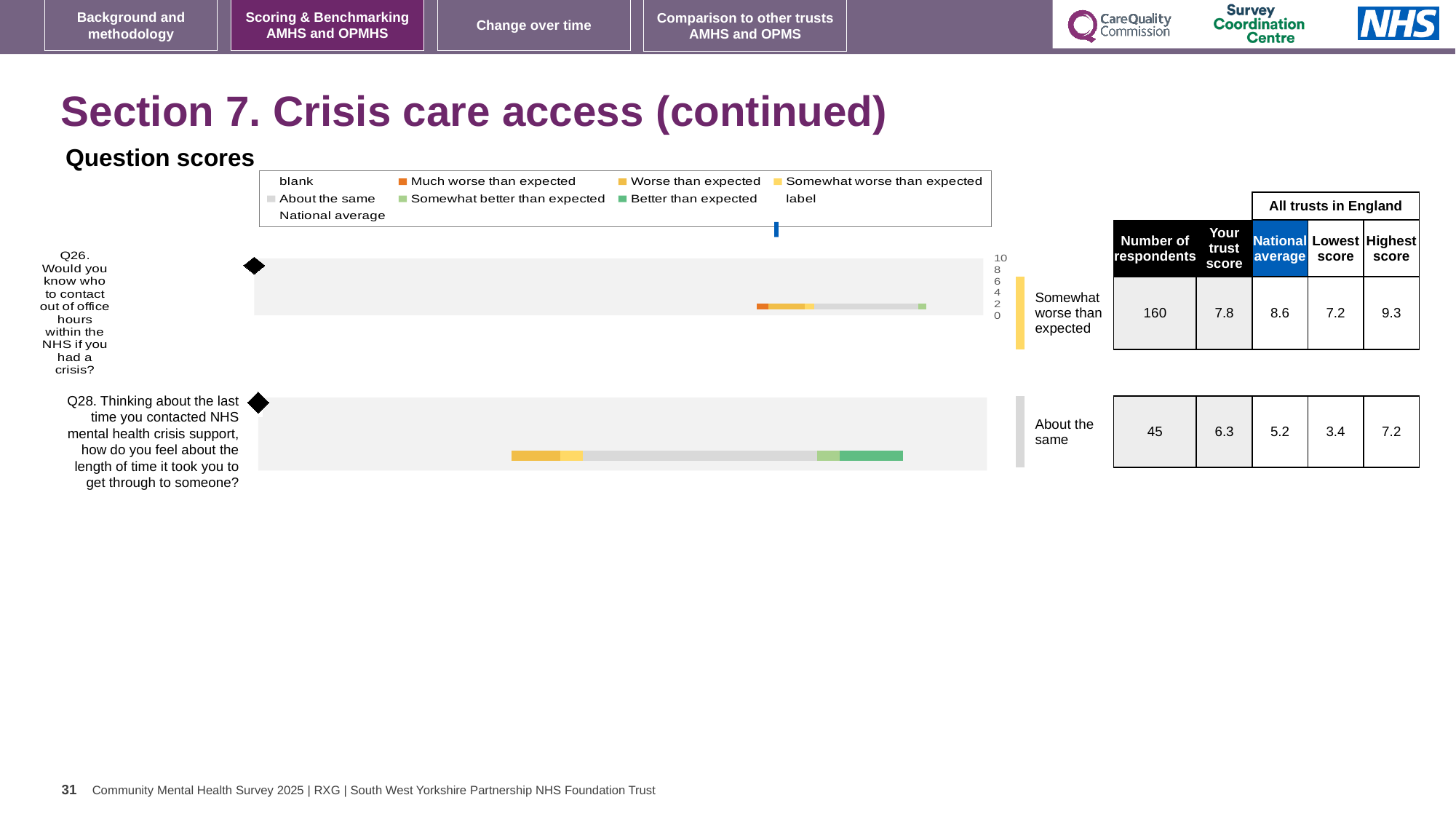
What colour represents 'Much worse than expected' in the chart legend? Orange According to the table beside the chart, what is the national average for Q28? 5.2 Which benchmark category is the trust's Q28 result placed in? About the same What is the highest score among all trusts in England for Q28? 7.2 By how much does the national average exceed the trust's score for Q26? 0.8 How many respondents answered Q26? 160 How many questions are plotted in the question scores chart? 2 Which question had more respondents, Q26 or Q28? Q26 For Q26, which is larger: the trust's score or the national average? National average What is the difference between the highest score and the lowest score for Q28? 3.8 According to the table beside the chart, what is the trust's score for Q26? 7.8 What kind of chart is used to show the question scores on this slide? bar chart